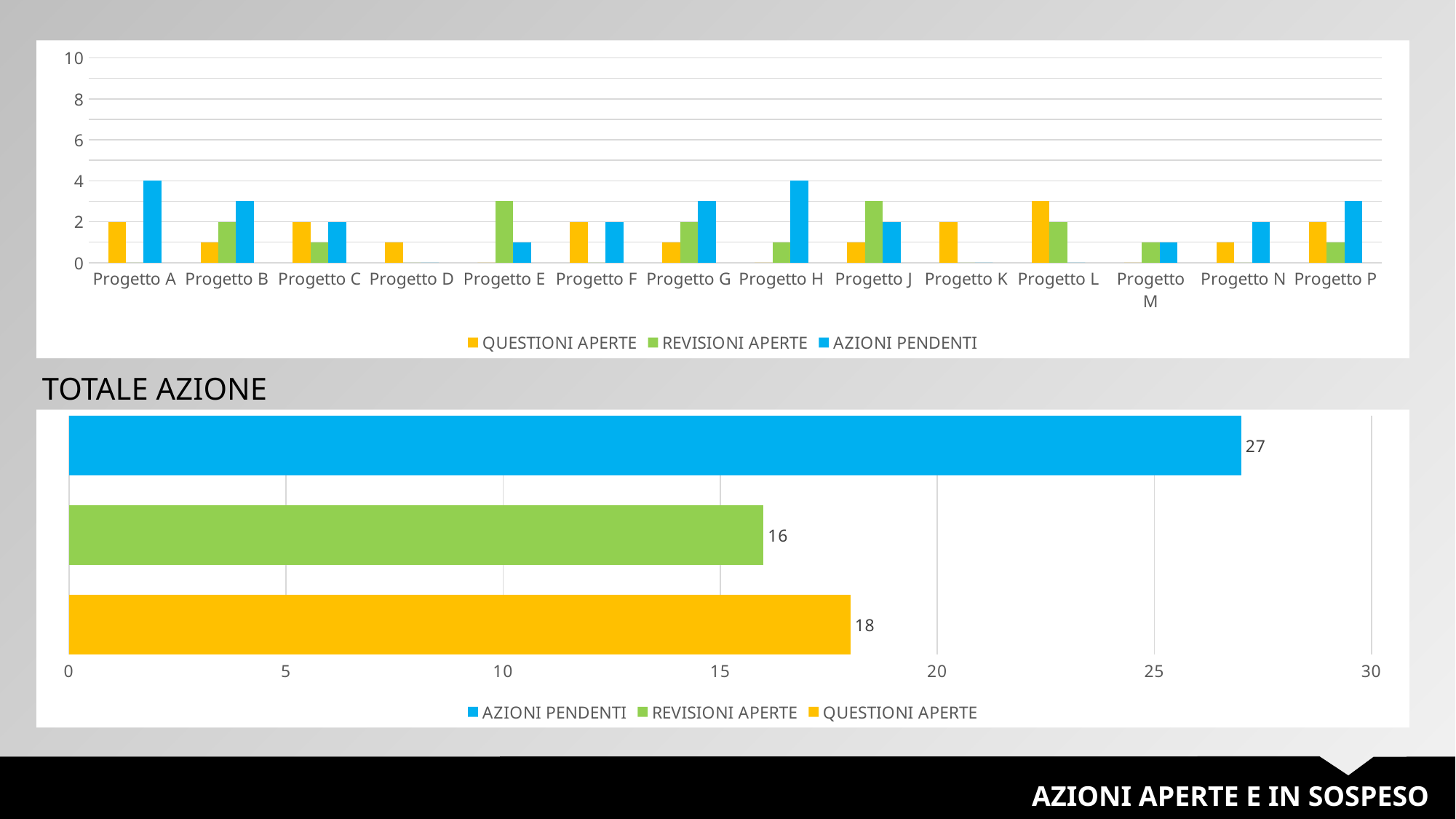
In the TOTALE AZIONE chart, what is the value for AZIONI PENDENTI? 27 In the TOTALE AZIONE chart, what is the value for REVISIONI APERTE? 16 In the TOTALE AZIONE chart, which category has the highest value? AZIONI PENDENTI In the top chart, is the QUESTIONI APERTE value for Progetto L greater or less than 2? greater In the TOTALE AZIONE chart, which is larger: QUESTIONI APERTE or REVISIONI APERTE? QUESTIONI APERTE In the top chart, how many series does the legend list? 3 In the TOTALE AZIONE chart, what is the difference between AZIONI PENDENTI and REVISIONI APERTE? 11 What kind of chart is the TOTALE AZIONE chart? bar chart In the top chart, what is the AZIONI PENDENTI value for Progetto A? 4 In the TOTALE AZIONE chart, which category has the lowest value? REVISIONI APERTE In the TOTALE AZIONE chart, what is the value for QUESTIONI APERTE? 18 In the top chart, how many projects are shown on the x axis? 14